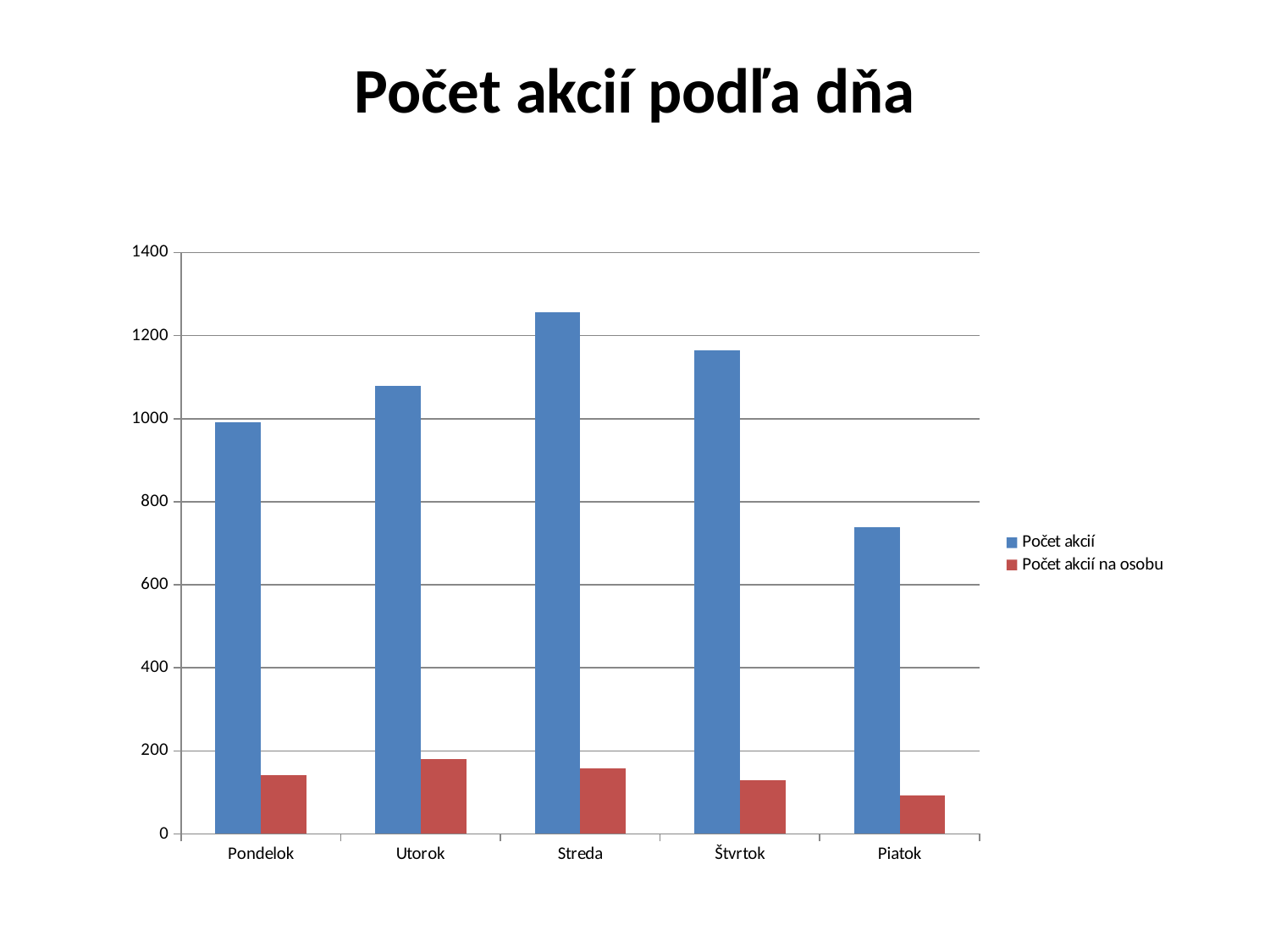
How many series does the legend list? 2 What is the title of the chart? Počet akcií podľa dňa Which day has the lowest value for Počet akcií na osobu? Piatok Does the value of Počet akcií rise or fall from Streda to Piatok? fall Which day has the highest value for Počet akcií na osobu? Utorok What kind of chart is shown on the slide? bar chart Which day has the highest value for Počet akcií? Streda Is the value of Počet akcií for Piatok greater or less than 800? less How many days (categories) are shown on the x axis? 5 Which is larger, Počet akcií for Štvrtok or for Utorok? Štvrtok Which day has the lowest value for Počet akcií? Piatok Is the value of Počet akcií for Streda greater or less than 1200? greater